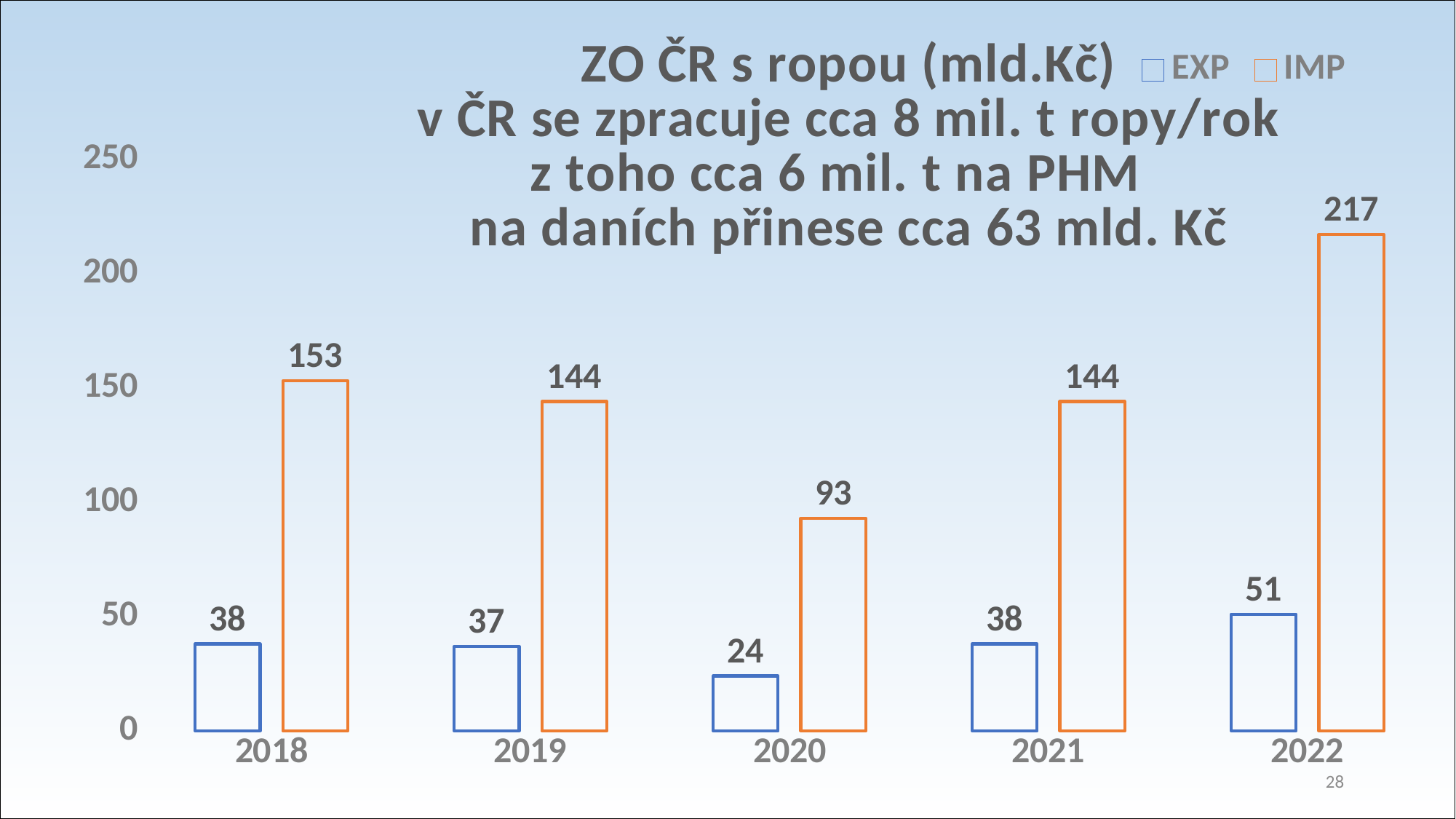
What is the IMP value for 2018? 153 How many series does the legend list? 2 What is the IMP value for 2022? 217 Which year has the lowest EXP value? 2020 What is the difference between the IMP and EXP values in 2022? 166 What kind of chart is shown on the slide? bar chart Which is larger, the IMP value for 2018 or the IMP value for 2019? IMP value for 2018 Which series is drawn in orange? IMP How many years are shown on the x axis? 5 What is the EXP value for 2020? 24 Which year has the highest IMP value? 2022 Is the IMP value for 2020 greater or less than 100? less